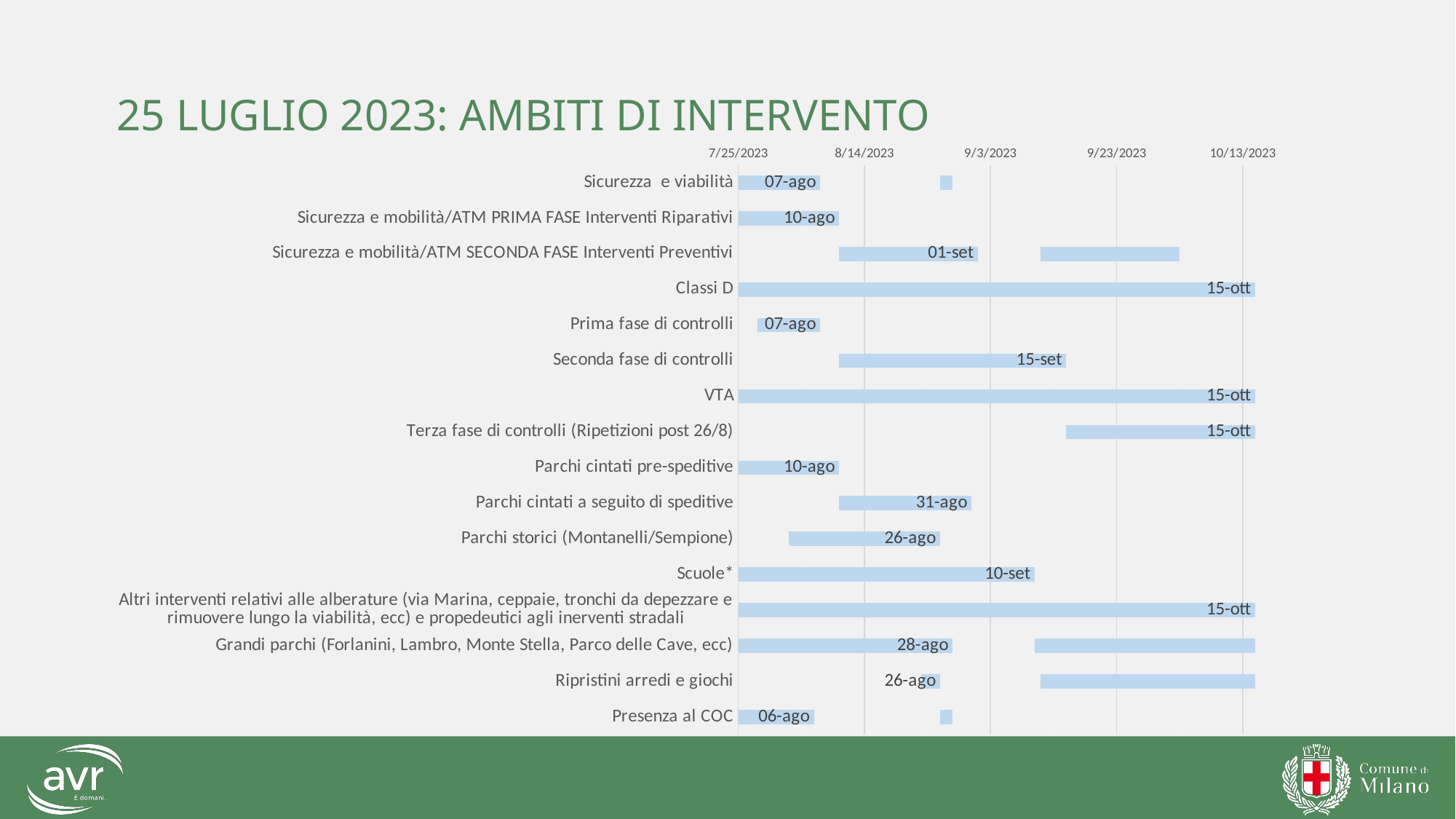
What date label is shown for Presenza al COC? 06-ago What is the first date shown on the horizontal axis? 7/25/2023 What is the title of the slide containing the chart? 25 LUGLIO 2023: AMBITI DI INTERVENTO What date label is shown for Parchi cintati a seguito di speditive? 31-ago What kind of chart is shown on the slide? Bar chart What date label is shown for Parchi storici (Montanelli/Sempione)? 26-ago What date label is shown for Seconda fase di controlli? 15-set What date label is shown for Scuole*? 10-set What date label is shown for Sicurezza e mobilità/ATM SECONDA FASE Interventi Preventivi? 01-set What is the end date label shown for Classi D? 15-ott How many activity rows (categories) are listed on the chart? 16 Which has the later labelled date, Seconda fase di controlli or Scuole*? Seconda fase di controlli